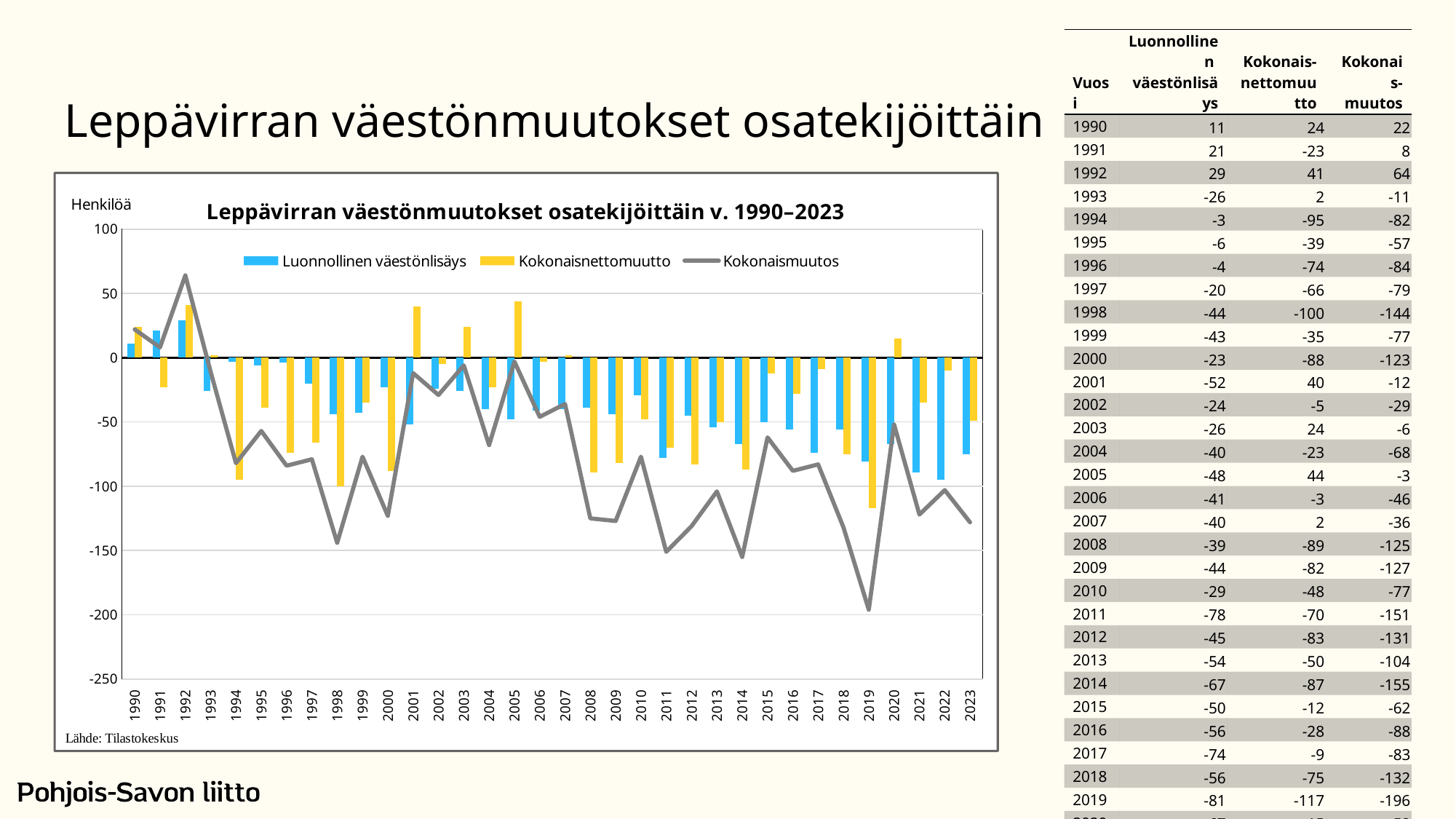
How many years are plotted along the x axis of the chart? 34 What is the difference between Kokonaisnettomuutto and Luonnollinen väestönlisäys in 1998? 56 Overall, does the Kokonaismuutos line rise or fall from 1990 to 2023? fall In which year is the Luonnollinen väestönlisäys bar highest? 1992 What kind of chart is shown on the slide? Combined bar and line chart In which year does the Kokonaismuutos line reach its lowest value? 2019 What is the Kokonaisnettomuutto value for 2005? 44 What is the Kokonaismuutos value for 1998? -144 In which year does the Kokonaismuutos line reach its highest value? 1992 How many series does the chart legend list? 3 In 1994, which is larger: Luonnollinen väestönlisäys or Kokonaisnettomuutto? Luonnollinen väestönlisäys Is the Kokonaismuutos value for 2023 greater or less than -100? less